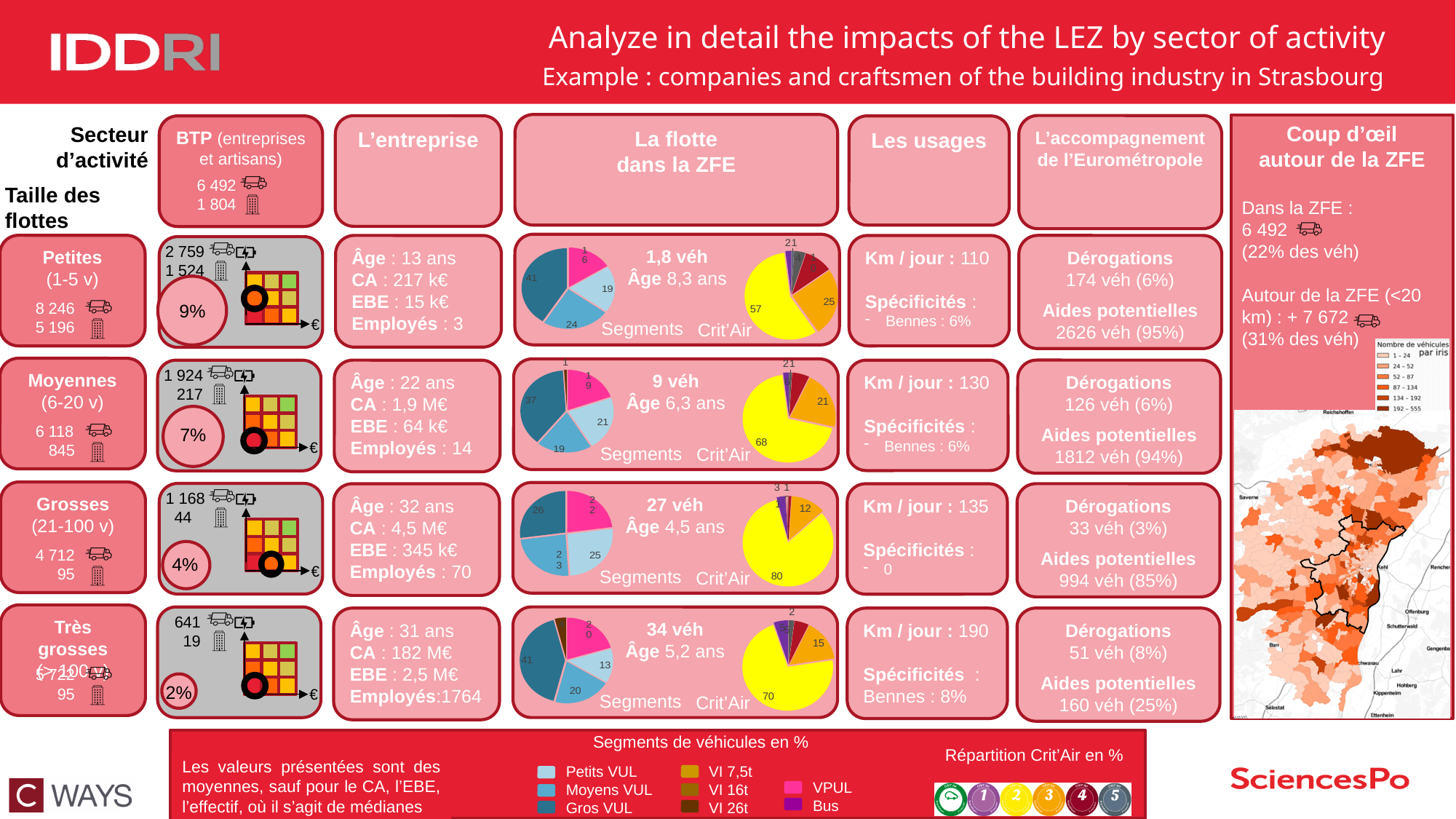
In the Segments pie chart for the 'Petites' fleet row, what is the value of the largest slice? 41 In the Segments pie chart for the 'Petites' fleet row, which is larger: the Moyens VUL slice or the Petits VUL slice? Moyens VUL What kind of charts are used in the 'La flotte dans la ZFE' column? Pie charts How many vehicle segments does the 'Segments de véhicules en %' legend list? 8 In the Crit'Air pie chart for the 'Petites' fleet row, what is the value of the yellow slice? 57 In the Crit'Air pie chart for the 'Très grosses' fleet row, what is the value of the yellow slice? 70 In the Crit'Air pie chart for the 'Grosses' fleet row, what is the value of the largest slice? 80 In the Crit'Air pie chart for the 'Petites' fleet row, what is the difference between the yellow slice (57) and the orange slice (25)? 32 In the Segments pie chart for the 'Grosses' fleet row, what is the value of the Petits VUL (light blue) slice? 25 In the Segments pie chart for the 'Petites' fleet row, which segment has the largest share? Gros VUL In the Crit'Air pie chart for the 'Moyennes' fleet row, what is the value of the yellow slice? 68 In the Segments pie chart for the 'Moyennes' fleet row, what is the value of the Gros VUL (dark teal) slice? 37